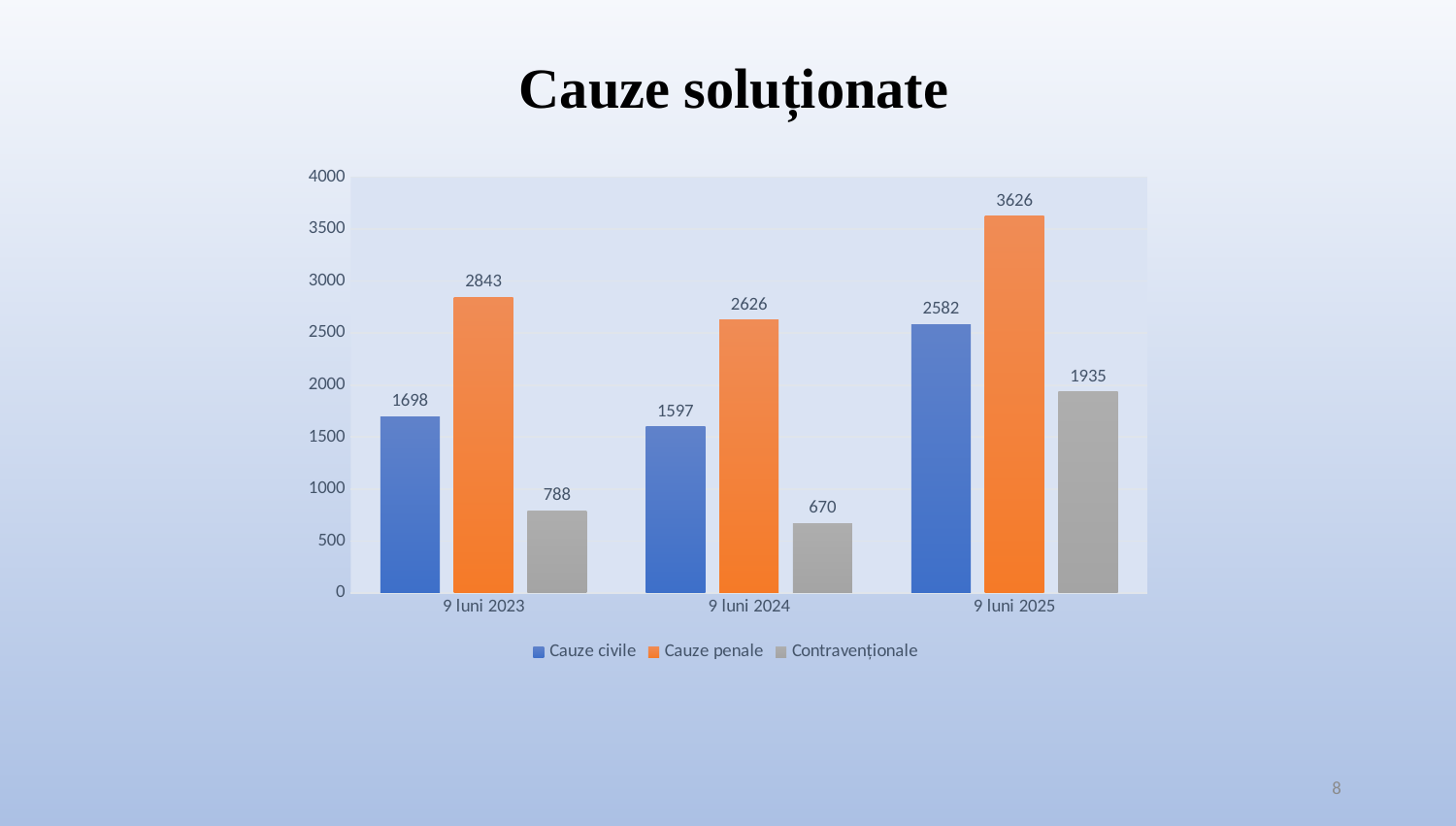
What is the title of the slide? Cauze soluționate What is the value for Cauze penale in 9 luni 2025? 3626 Which period has the lowest value for Contravenționale? 9 luni 2024 What is the value for Contravenționale in 9 luni 2024? 670 What is the value for Cauze civile in 9 luni 2023? 1698 What is the difference between Contravenționale in 9 luni 2025 and 9 luni 2023? 1147 How many periods are shown on the x axis? 3 Which period has the highest value for Cauze penale? 9 luni 2025 Which is larger: Cauze civile in 9 luni 2023 or Cauze civile in 9 luni 2024? 9 luni 2023 How many series does the legend list? 3 What kind of chart is shown on the slide? bar chart What is the difference between Cauze penale in 9 luni 2025 and 9 luni 2024? 1000